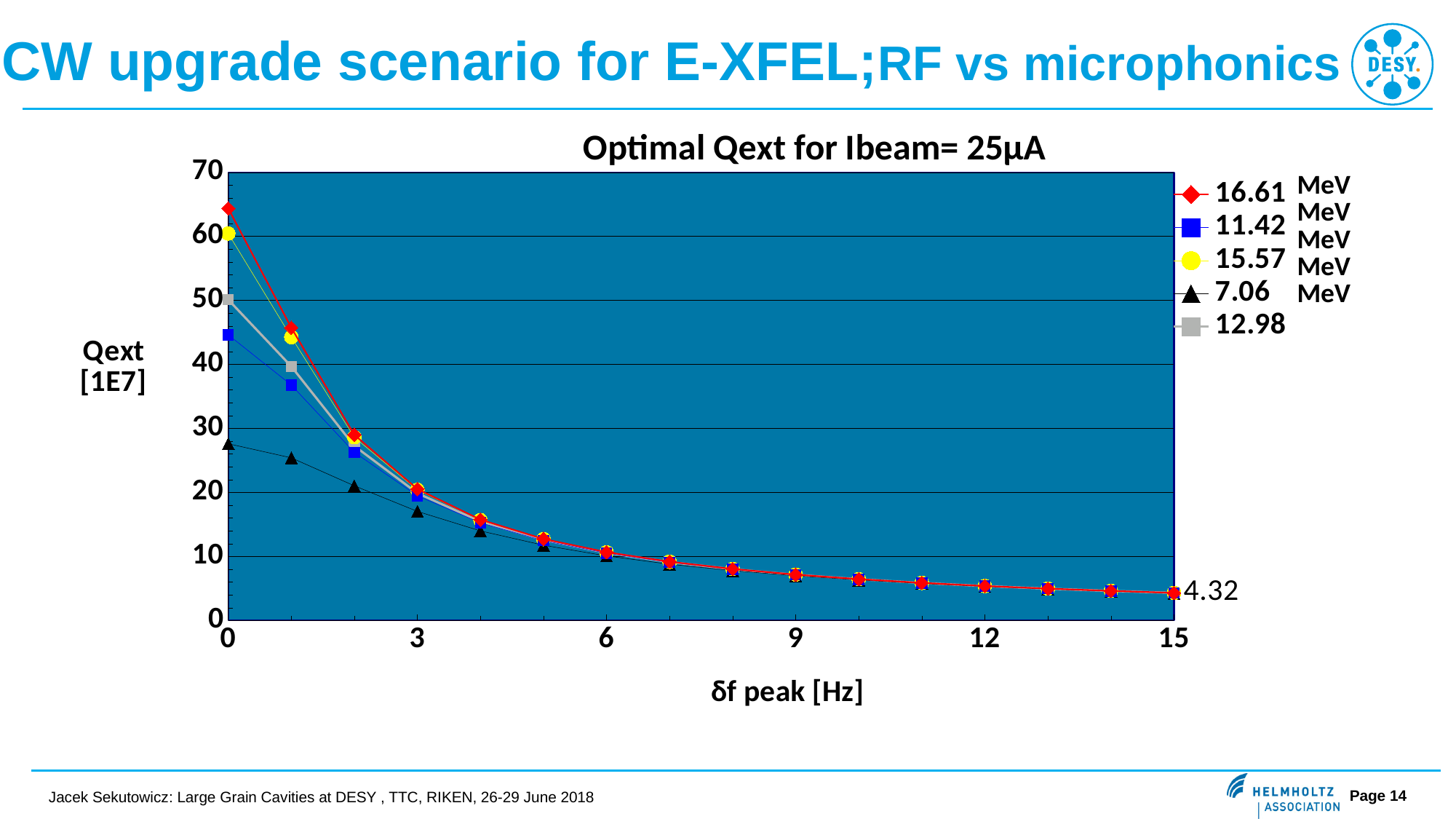
How many series does the legend list? 5 What is the title of the chart? Optimal Qext for Ibeam= 25μA Is the Qext value for the 11.42 MeV series at 0 Hz greater or less than 40? greater Do the Qext values rise or fall as δf peak increases? fall Which series has the lowest Qext at δf peak = 0 Hz? 7.06 MeV What is the label of the x axis? δf peak [Hz] Which series has the highest Qext at δf peak = 0 Hz? 16.61 MeV At δf peak = 0 Hz, which series has the larger Qext: 12.98 MeV or 7.06 MeV? 12.98 MeV What Qext value is labelled on the chart at δf peak = 15 Hz? 4.32 Is the Qext value for the 16.61 MeV series at 0 Hz greater or less than 60? greater What kind of chart is shown on the slide? line chart Is the Qext value for the 7.06 MeV series at 0 Hz greater or less than 30? less